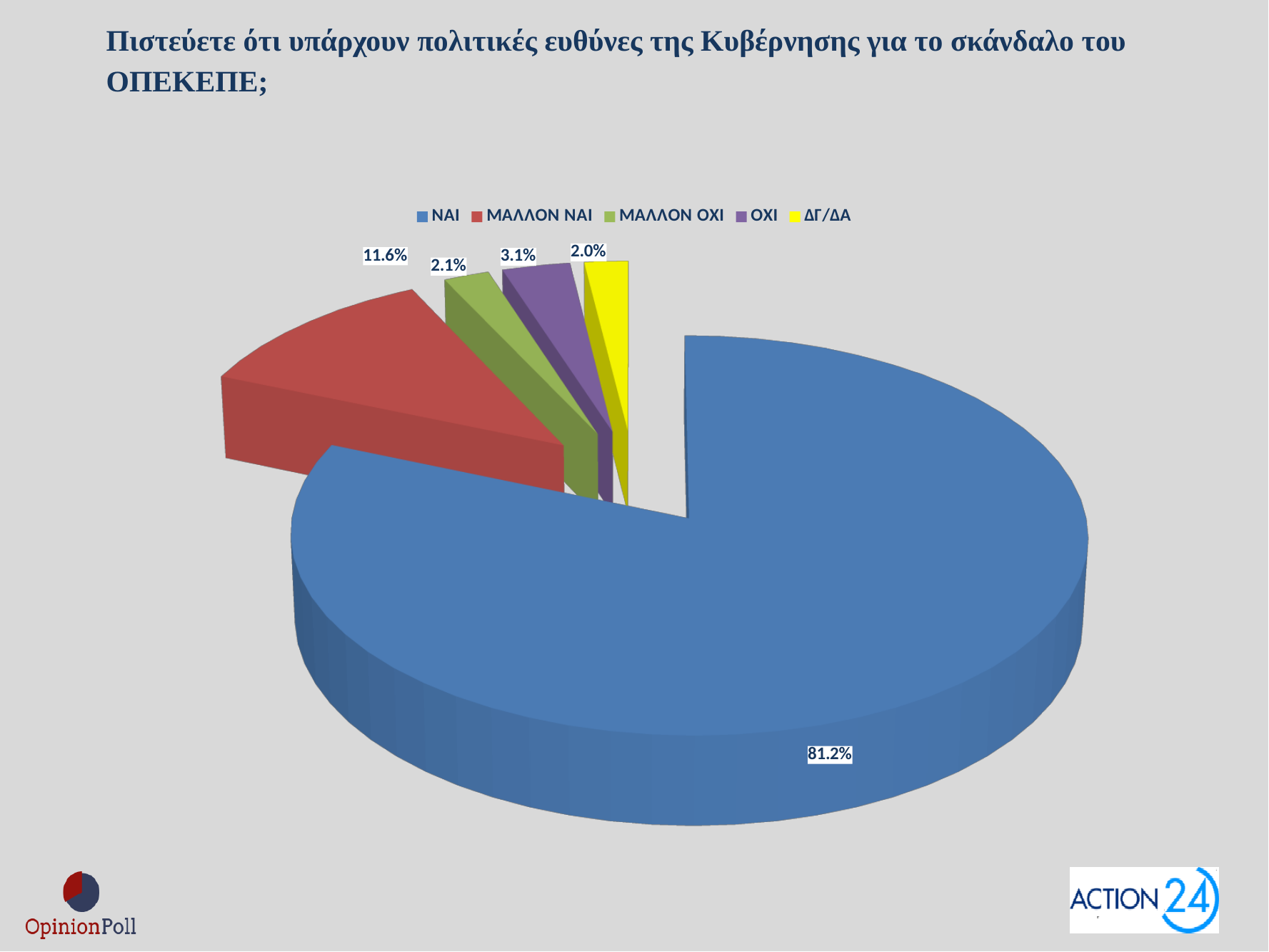
Which category has the smallest share of the pie? ΔΓ/ΔΑ What percentage is shown for ΔΓ/ΔΑ? 2.0% What percentage is shown for ΝΑΙ? 81.2% What percentage is shown for ΜΑΛΛΟΝ ΝΑΙ? 11.6% Which is larger, the share for ΟΧΙ or the share for ΜΑΛΛΟΝ ΟΧΙ? ΟΧΙ What kind of chart is shown on the slide? Pie chart Which category has the largest share of the pie? ΝΑΙ How many categories does the legend list? 5 What colour is the slice for ΜΑΛΛΟΝ ΝΑΙ? Red What percentage is shown for ΟΧΙ? 3.1% What percentage is shown for ΜΑΛΛΟΝ ΟΧΙ? 2.1% What is the difference in percentage points between ΝΑΙ and ΜΑΛΛΟΝ ΝΑΙ? 69.6